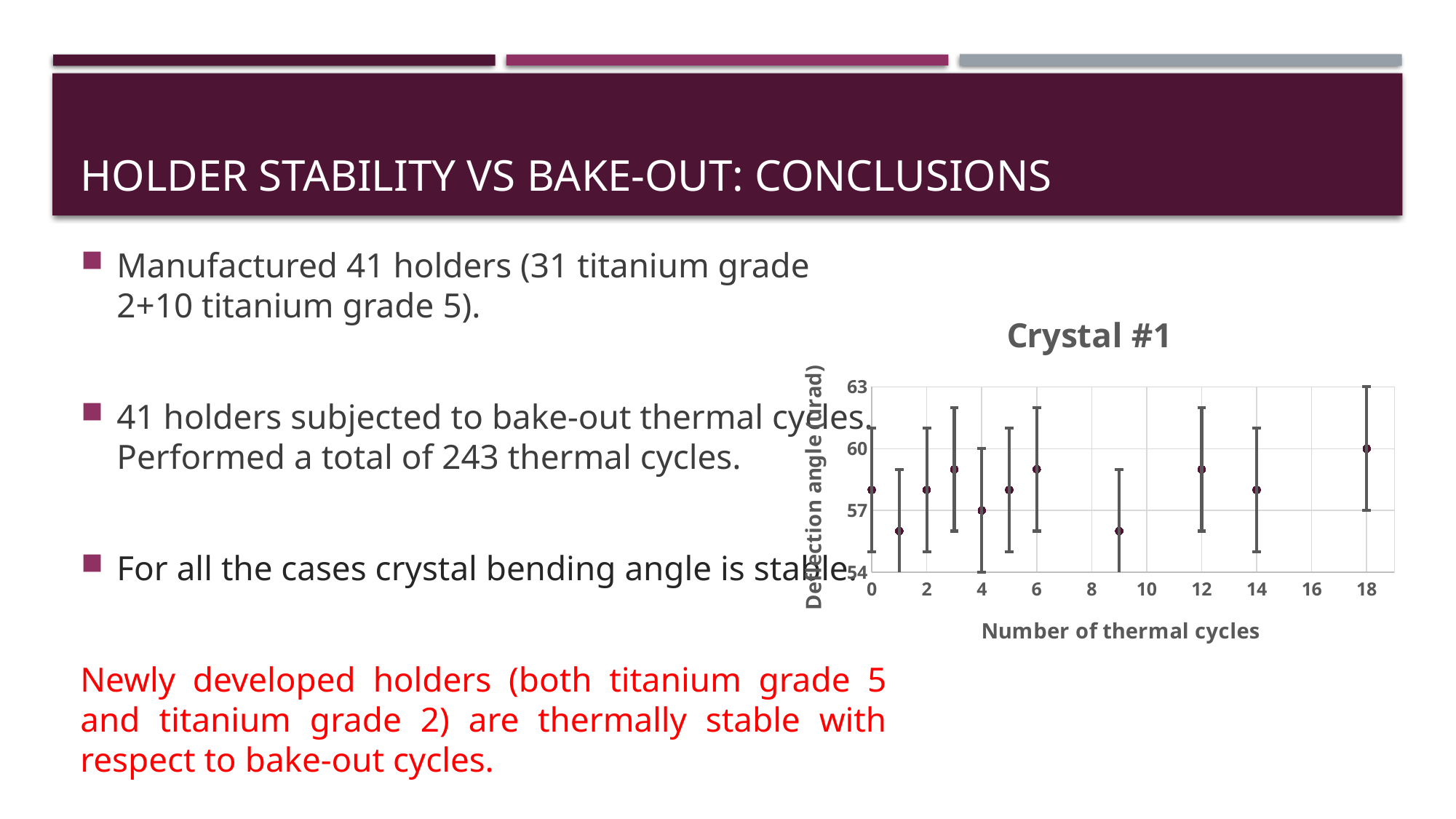
In the Crystal #1 chart, what is the deflection angle at 18 thermal cycles? 60 In the Crystal #1 chart, is the deflection angle at 0 thermal cycles greater or less than 57? greater How many data points are plotted in the Crystal #1 chart? 11 In the Crystal #1 chart, is the deflection angle at 9 thermal cycles greater or less than 57? less What kind of chart is the Crystal #1 chart? Scatter chart with error bars In the Crystal #1 chart, what is the deflection angle at 4 thermal cycles? 57 What is the title of the chart on the slide? Crystal #1 In the Crystal #1 chart, is the deflection angle at 1 thermal cycle greater or less than 57? less In the Crystal #1 chart, does the deflection angle show a strong rising or falling trend with the number of thermal cycles, or does it stay roughly stable? Roughly stable In the Crystal #1 chart, which is larger: the deflection angle at 1 thermal cycle or at 18 thermal cycles? 18 thermal cycles What is the label of the x axis of the Crystal #1 chart? Number of thermal cycles